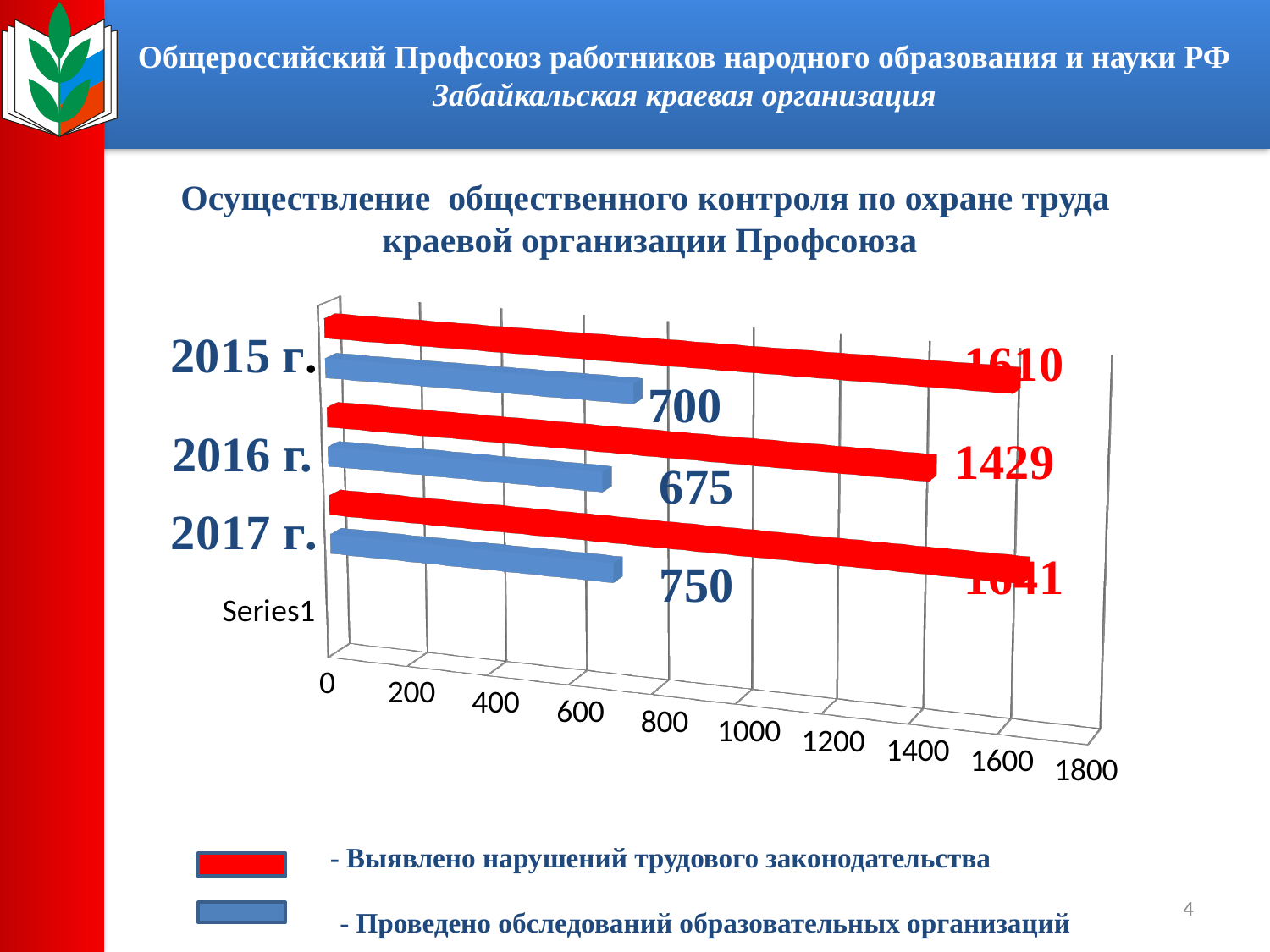
How many years are shown on the chart? 3 In which year was the number of inspections of educational organisations the lowest? 2016 г. How many inspections of educational organisations were carried out in 2016 г.? 675 What type of chart is shown on the slide? Bar chart In which year was the number of inspections of educational organisations the highest? 2017 г. How many violations of labour legislation were identified in 2016 г.? 1429 Which year had more identified violations of labour legislation, 2015 г. or 2016 г.? 2015 г. By how much did the number of identified violations decrease from 2015 г. to 2016 г.? 181 How many inspections of educational organisations (Проведено обследований образовательных организаций) were carried out in 2015 г.? 700 What is the difference between the number of inspections in 2017 г. and in 2016 г.? 75 How many inspections of educational organisations were carried out in 2017 г.? 750 How many violations of labour legislation (Выявлено нарушений трудового законодательства) were identified in 2015 г.? 1610